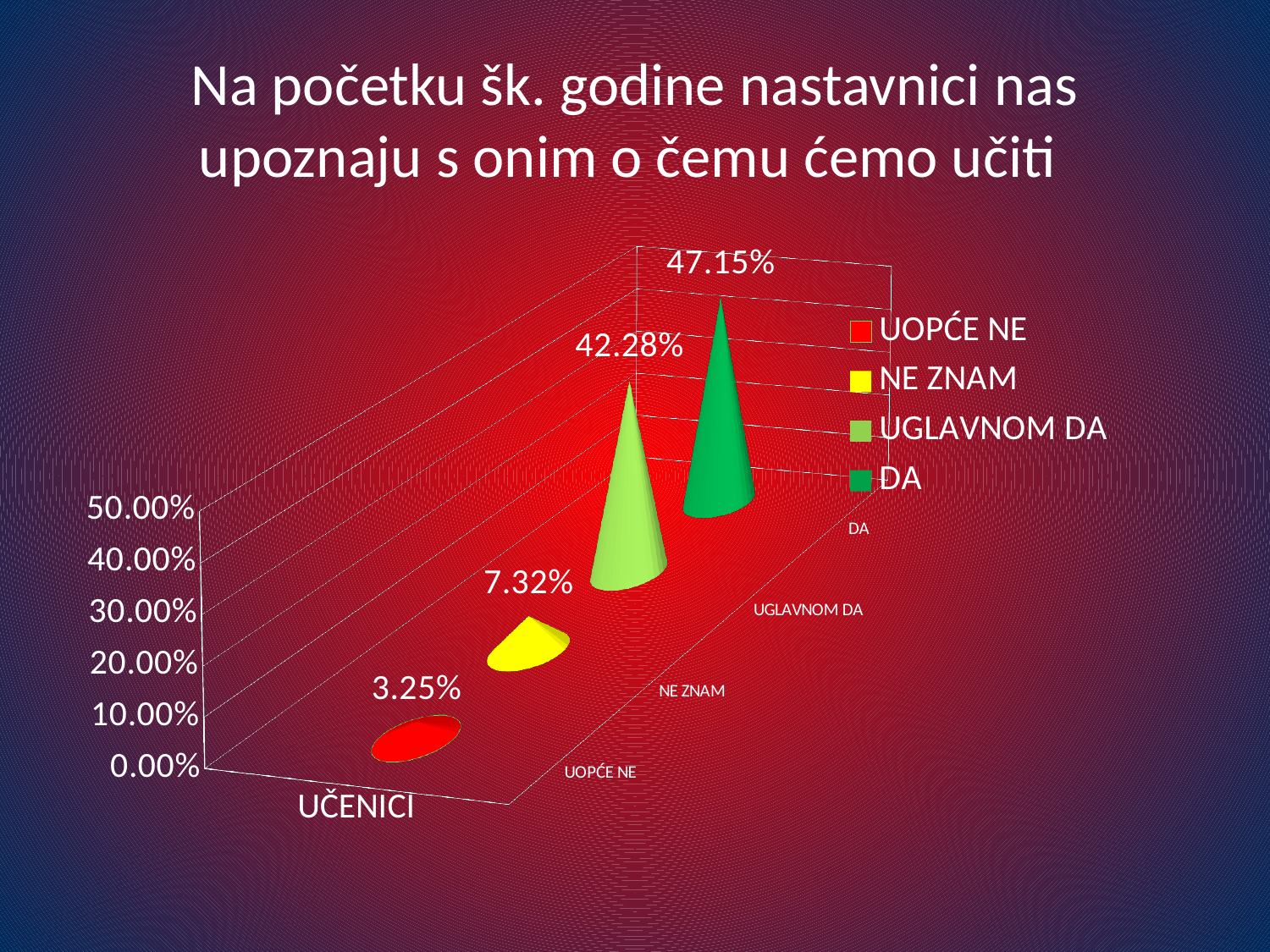
Which is larger, the value for NE ZNAM or the value for UOPĆE NE? NE ZNAM Which series has the lowest value? UOPĆE NE How many series does the legend list? 4 What is the value for UGLAVNOM DA? 42.28% What is the value for NE ZNAM? 7.32% What is the difference between the values for DA and UGLAVNOM DA? 4.87% What colour represents the DA series in the legend? green Which series has the highest value? DA What is the value for UOPĆE NE? 3.25% What is the value for DA? 47.15% What is the difference between the values for NE ZNAM and UOPĆE NE? 4.07% What kind of chart is shown on the slide? bar chart